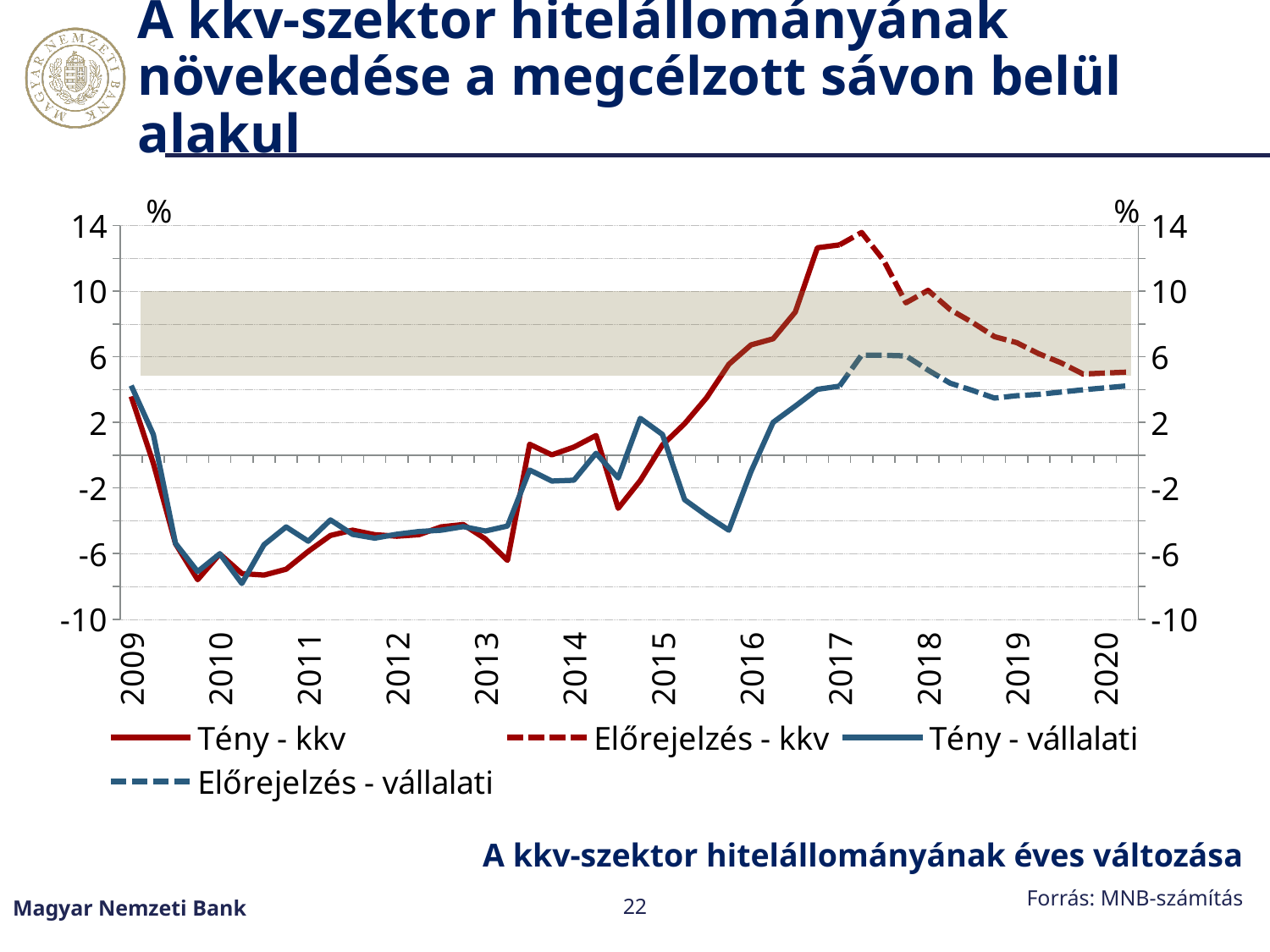
In which year does Tény - kkv reach its highest value? 2017 Is the value of Tény - vállalati at the start of 2016 greater or less than -2? greater Is the value of Előrejelzés - vállalati at 2019 greater or less than 2? greater Does Előrejelzés - kkv rise or fall from 2017 to 2020? fall How many year labels are shown on the x axis? 12 At 2017, which is larger: Tény - kkv or Tény - vállalati? Tény - kkv What unit is shown on the vertical axes? % How many series does the legend list? 4 Is the peak value of Tény - kkv around 2017 greater or less than 10? greater What kind of chart is shown on the slide? line chart What is the title of the chart? A kkv-szektor hitelállományának éves változása